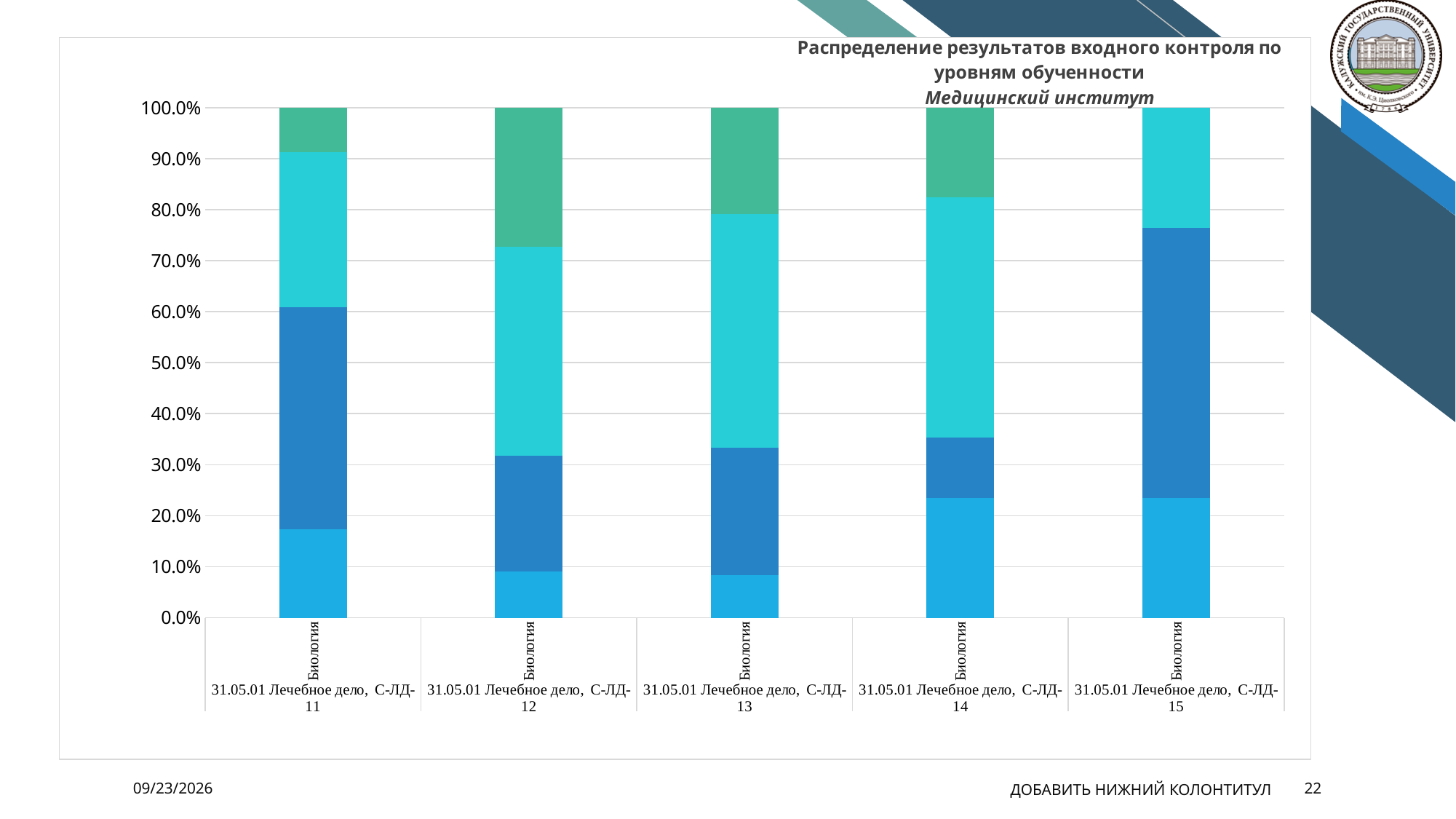
What is the title of the chart? Распределение результатов входного контроля по уровням обученности Медицинский институт How many categories (groups) are shown along the x axis of the chart? 5 Is the top of the dark blue segment for 31.05.01 Лечебное дело, С-ЛД-11 greater or less than 50.0%? greater Which category has no green (top) segment in its bar? 31.05.01 Лечебное дело, С-ЛД-15 Is the bottom (light blue) segment of the bar for 31.05.01 Лечебное дело, С-ЛД-13 greater or less than 10.0%? less Is the bottom (light blue) segment of the bar for 31.05.01 Лечебное дело, С-ЛД-11 greater or less than 20.0%? less What kind of chart is shown on the slide? stacked bar chart Which category has the largest dark blue segment: 31.05.01 Лечебное дело, С-ЛД-15 or 31.05.01 Лечебное дело, С-ЛД-12? 31.05.01 Лечебное дело, С-ЛД-15 What is the total height of each stacked bar in the chart? 100.0% Which category has the largest green (top) segment? 31.05.01 Лечебное дело, С-ЛД-12